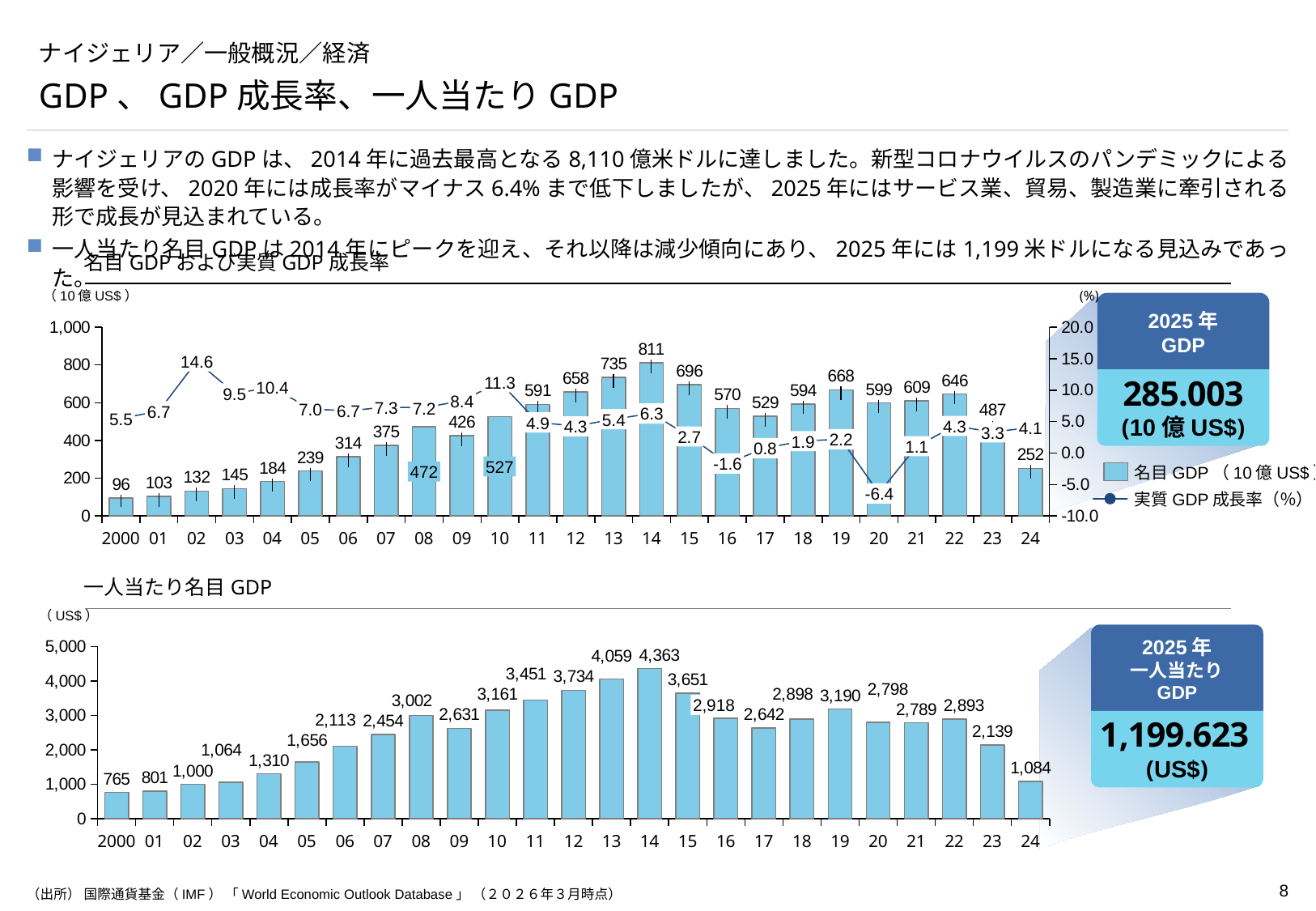
In the bottom chart, which year has the lowest GDP per capita? 2000 In the top chart, what is the real GDP growth rate for 2020? -6.4 In the bottom chart, what is the difference between the values for 2023 and 2024? 1,055 In the top chart (名目GDPおよび実質GDP成長率), what is the nominal GDP value for 2014? 811 In the top chart, which year has the lowest nominal GDP bar? 2000 In the top chart, which year has the highest real GDP growth rate? 2002 In the top chart, what is the difference between the nominal GDP of 2014 and 2024? 559 In the top chart, how many series does the legend list? 2 In the bottom chart, is the value for 2008 larger than the value for 2009? Yes In the bottom chart (一人当たり名目GDP), what is the value for 2014? 4,363 How many years are plotted on the x axis of the bottom chart? 25 What type of chart is the bottom chart (一人当たり名目GDP)? Bar chart